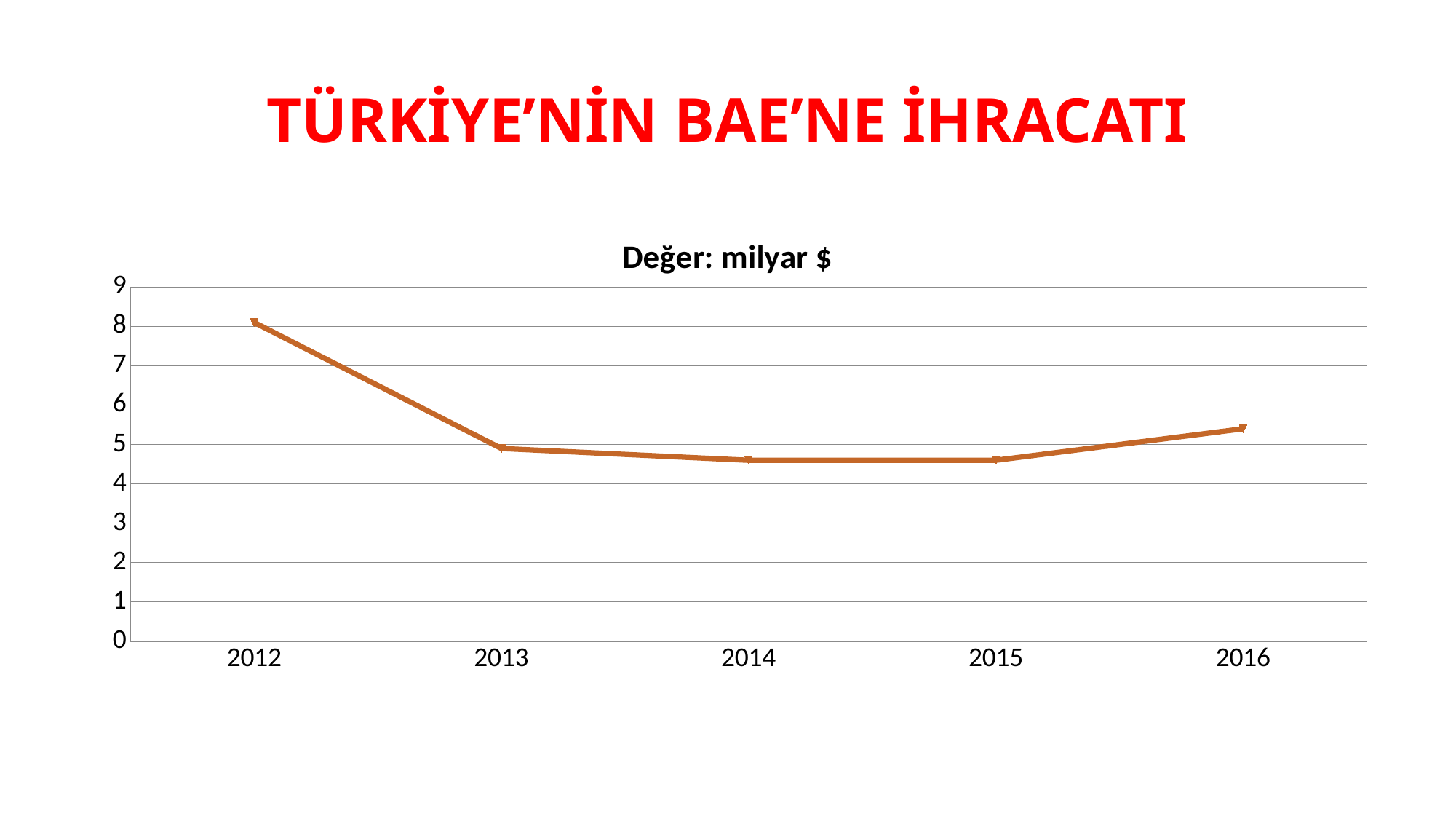
What is the title shown above the chart? Değer: milyar $ Which year has the highest value in the chart? 2012 Which is larger, the value for 2012 or the value for 2016? 2012 How many years are plotted on the x axis of the chart? 5 What kind of chart is shown on the slide? line chart Does the value rise or fall from 2012 to 2013? fall Which is larger, the value for 2015 or the value for 2016? 2016 Is the value for 2015 greater or less than 5? less Is the value for 2014 greater or less than 4? greater Is the value for 2016 greater or less than 5? greater